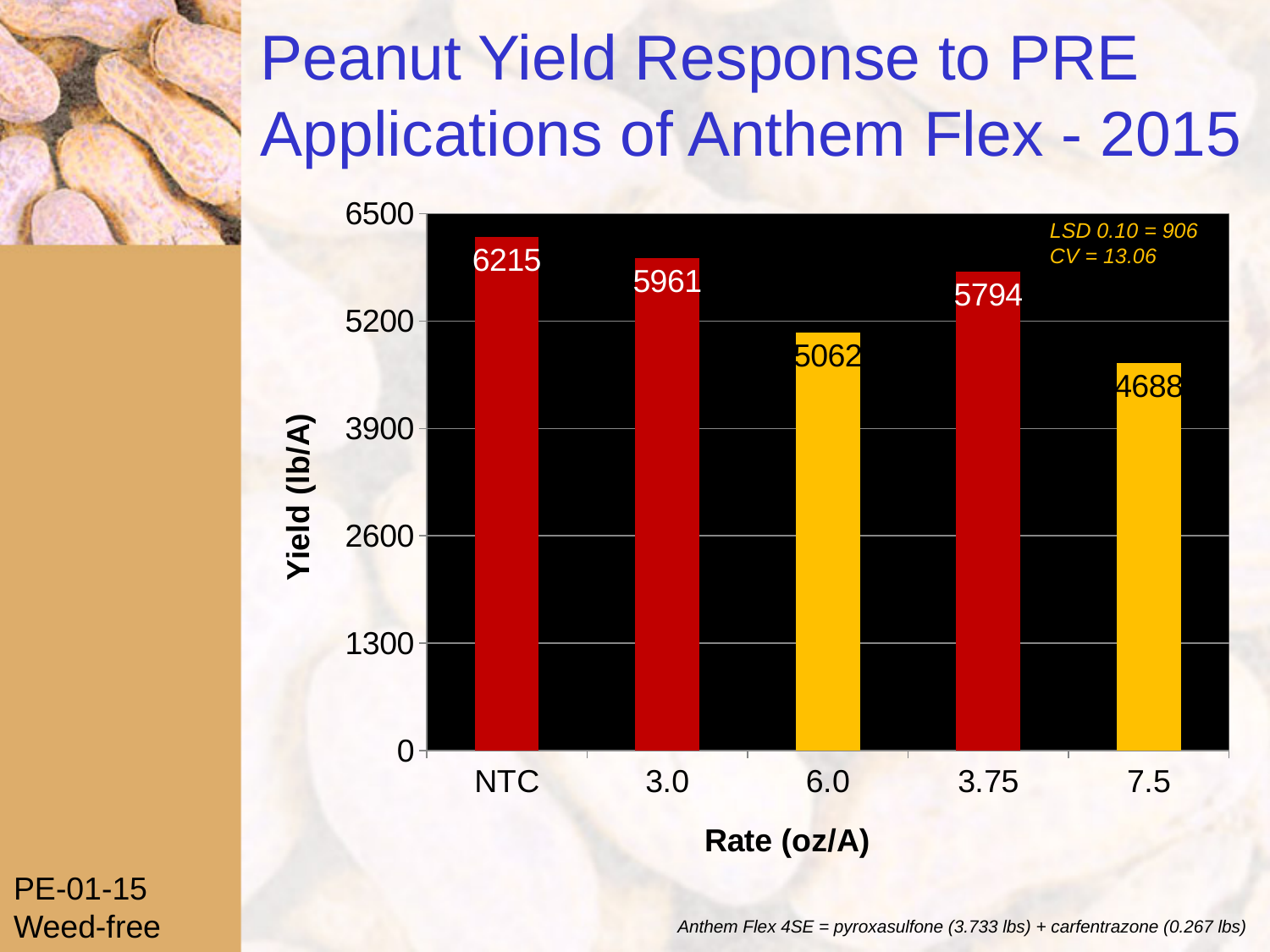
Is the yield at the 6.0 oz/A rate greater or less than 5200? less What is the difference in yield between the 3.0 and 3.75 oz/A rates? 167 What is the difference in yield between NTC and the 7.5 oz/A rate? 1527 What is the yield at the 6.0 oz/A rate? 5062 Which rate category has the highest yield? NTC What is the yield for the NTC treatment? 6215 What is the yield at the 7.5 oz/A rate? 4688 Which has a higher yield, the 3.0 oz/A rate or the 6.0 oz/A rate? 3.0 How many rate categories are shown on the x axis? 5 What kind of chart is shown on the slide? bar chart Which rate category has the lowest yield? 7.5 What is the y-axis label of the chart? Yield (lb/A)